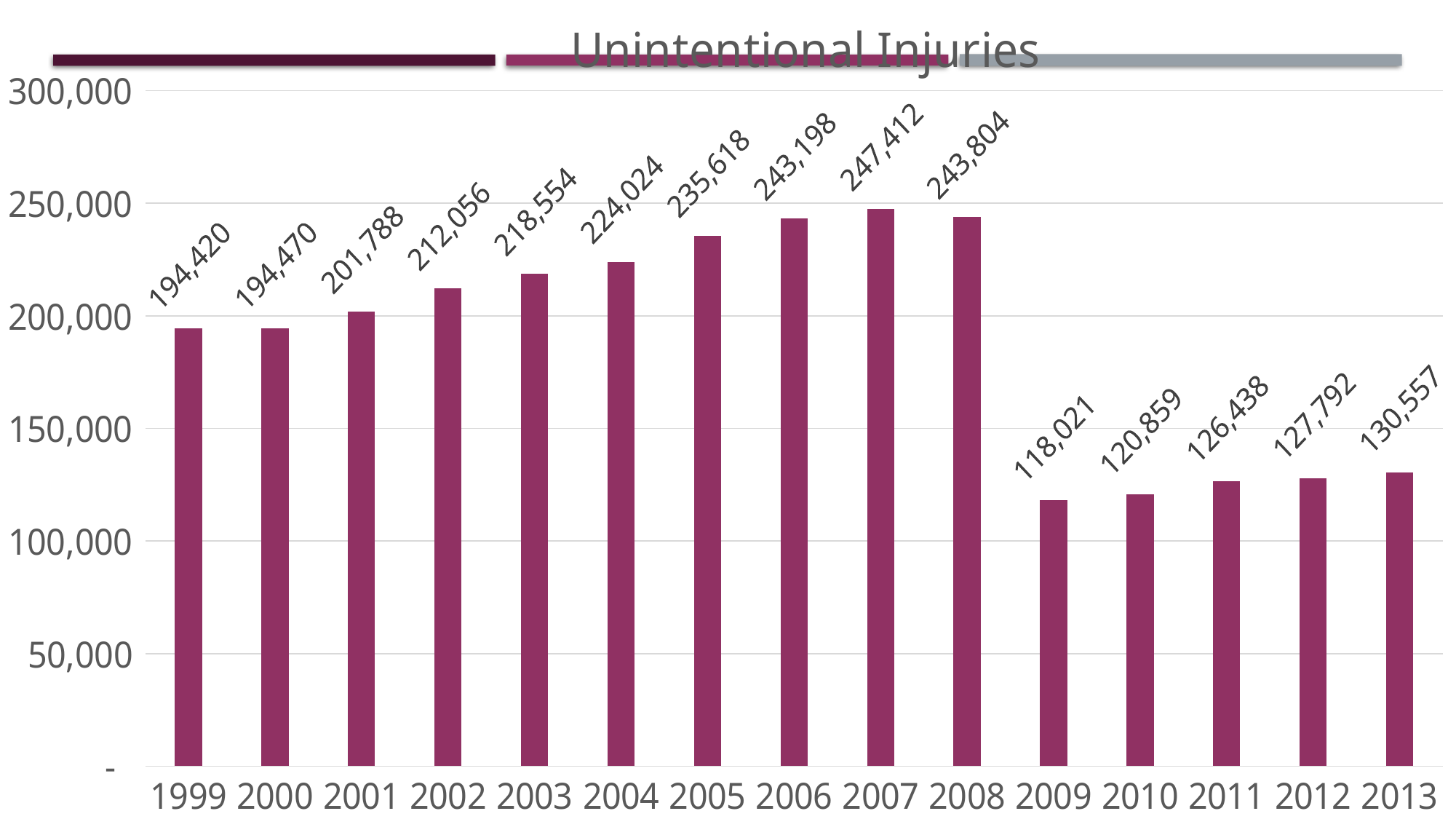
How many years are shown on the x axis? 15 Which is larger, the value for 2003 or the value for 2013? 2003 Which year has the lowest value? 2009 What is the value for 2007? 247,412 Is the value for 2005 greater or less than 200,000? greater What is the title of the chart? Unintentional Injuries What is the difference between the values for 2008 and 2009? 125,783 What is the value for 2009? 118,021 Which year has the highest value? 2007 What is the value for 1999? 194,420 Do the values rise or fall from 2009 to 2013? rise What kind of chart is this? bar chart